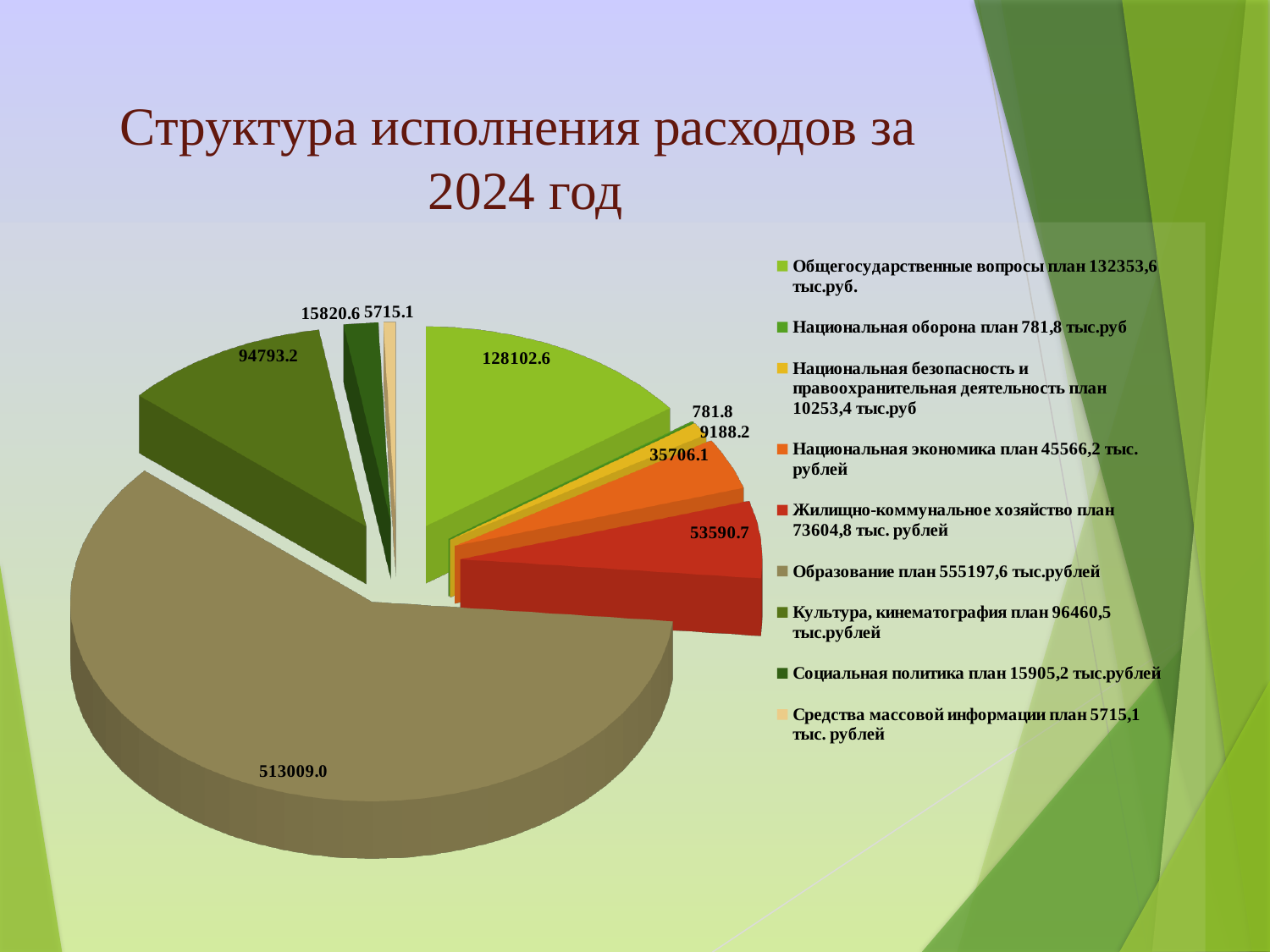
What type of chart is shown on the slide? Pie chart What is the value shown for the Жилищно-коммунальное хозяйство slice? 53590.7 How many slices does the pie chart have? 9 Which is larger: the value for Социальная политика or the value for Средства массовой информации? Социальная политика What is the value shown for the Образование slice? 513009.0 What is the difference between the values for Общегосударственные вопросы and Культура, кинематография? 33309.4 What is the value shown for the Национальная оборона slice? 781.8 What is the title of the slide containing the chart? Структура исполнения расходов за 2024 год Which category has the smallest slice of the pie? Национальная оборона Which category has the largest slice of the pie? Образование What is the difference between the values for Жилищно-коммунальное хозяйство and Национальная экономика? 17884.6 What is the value shown for the Общегосударственные вопросы slice? 128102.6